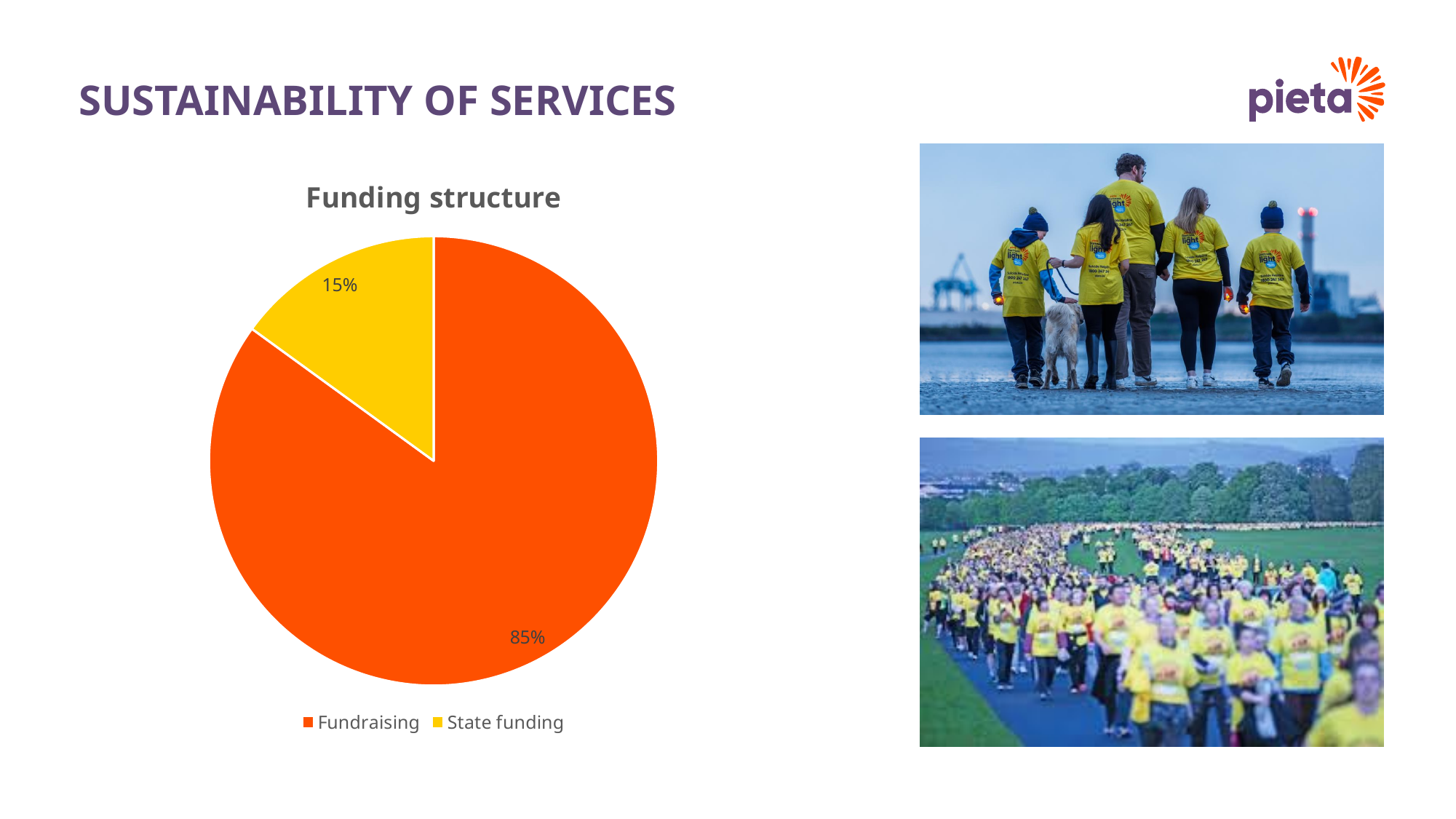
Which funding source has the largest slice of the pie? Fundraising What share of the funding structure comes from Fundraising? 85% What share of the funding structure comes from State funding? 15% How many entries does the legend list? 2 What is the title of the chart? Funding structure Is the share for Fundraising greater or less than 50%? greater What kind of chart is shown on the slide? Pie chart What colour is the State funding slice? Yellow What is the difference in percentage points between Fundraising and State funding? 70 How many slices does the pie chart have? 2 Which is larger, Fundraising or State funding? Fundraising Which funding source has the smallest slice of the pie? State funding